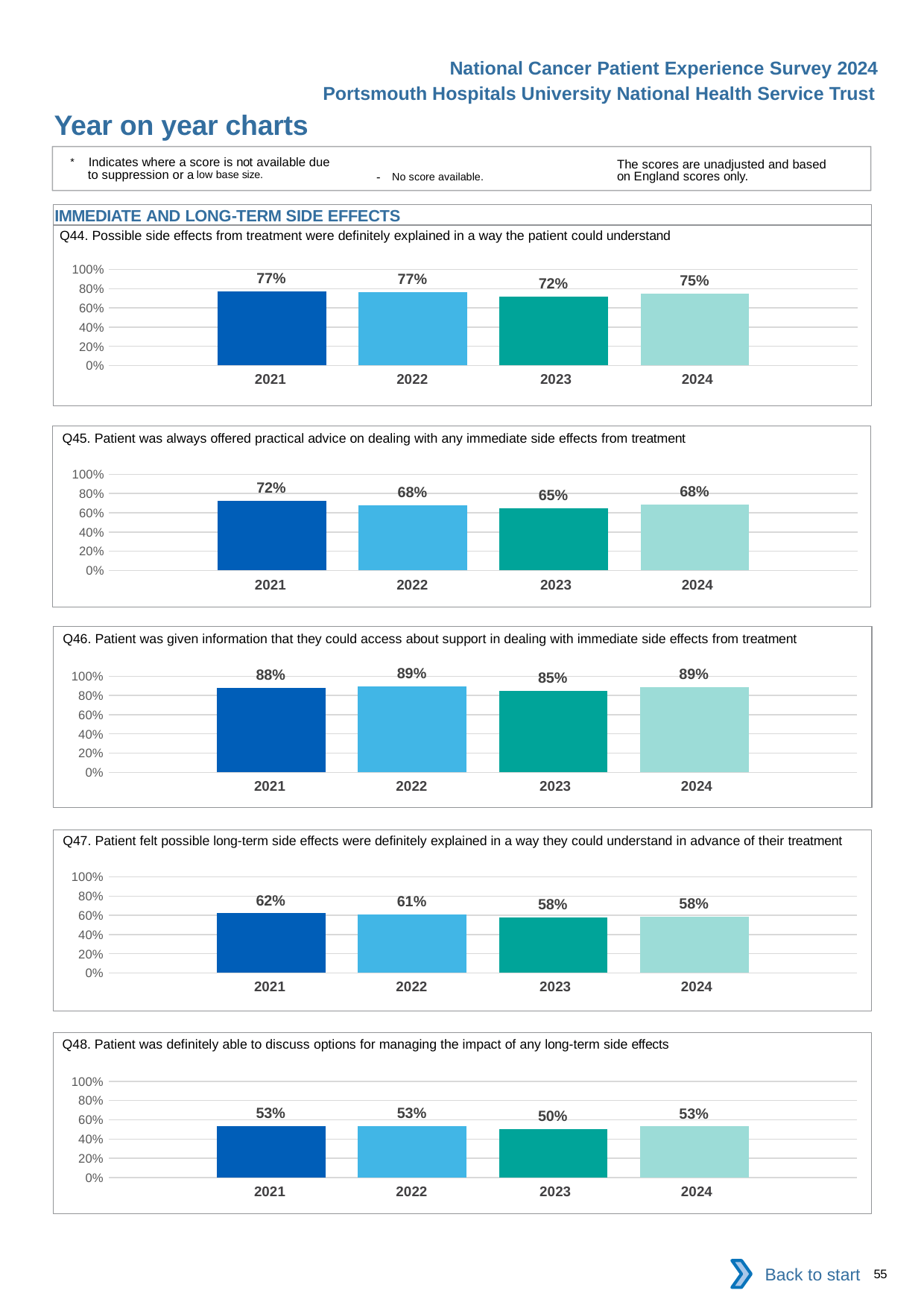
In the Q46 chart, what is the value for 2023? 85% In the Q45 chart, what is the difference between the 2021 and 2023 values? 7% In the Q47 chart, do the values generally rise or fall from 2021 to 2024? fall In the Q48 chart, what is the value for 2023? 50% In the Q46 chart, is the value for 2022 larger or smaller than the value for 2023? larger In the Q45 chart, which year has the highest value? 2021 In the Q48 chart, how many years are shown on the x axis? 4 What kind of chart is the Q47 chart? bar chart In the Q47 chart, is the value for 2024 greater or less than 60%? less In the Q47 chart, what is the value for 2021? 62% In the Q44 chart, which year has the lowest value? 2023 In the Q44 chart, what is the value for 2024? 75%